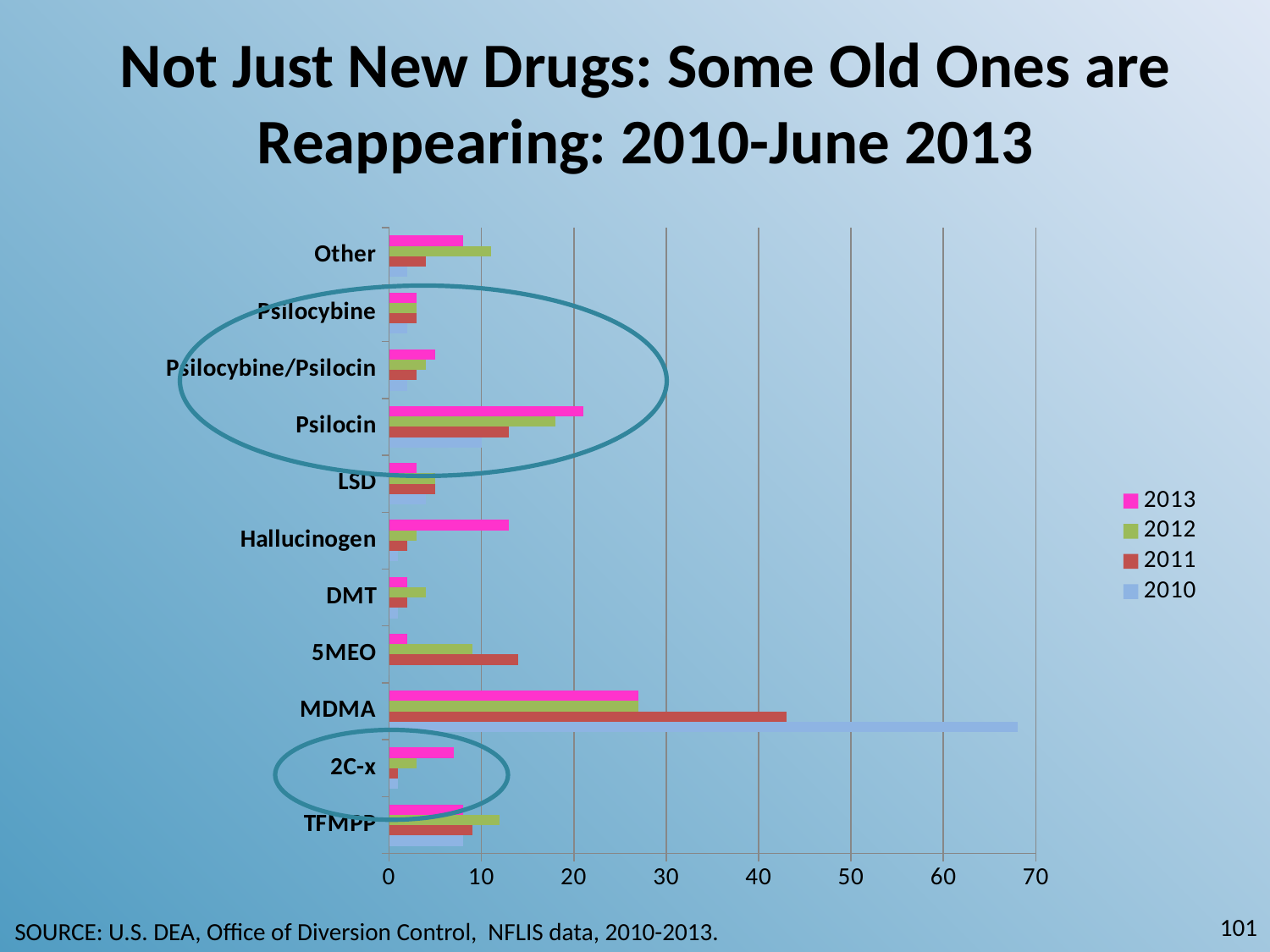
Is the 2010 value for MDMA greater or less than 60? greater For MDMA, which year has the longest bar? 2010 Is the 2010 value for 2C-x greater or less than 10? less Is the 2011 value for MDMA greater or less than 40? greater For 5MEO, which is larger: the 2011 value or the 2013 value? 2011 Which drug category has the longest bar in the chart? MDMA Which years are listed in the chart's legend? 2013, 2012, 2011, 2010 How many drug categories are listed on the vertical axis of the chart? 11 For Psilocin, which is larger: the 2013 value or the 2011 value? 2013 How many series does the chart's legend list? 4 What kind of chart is shown on the slide? bar chart